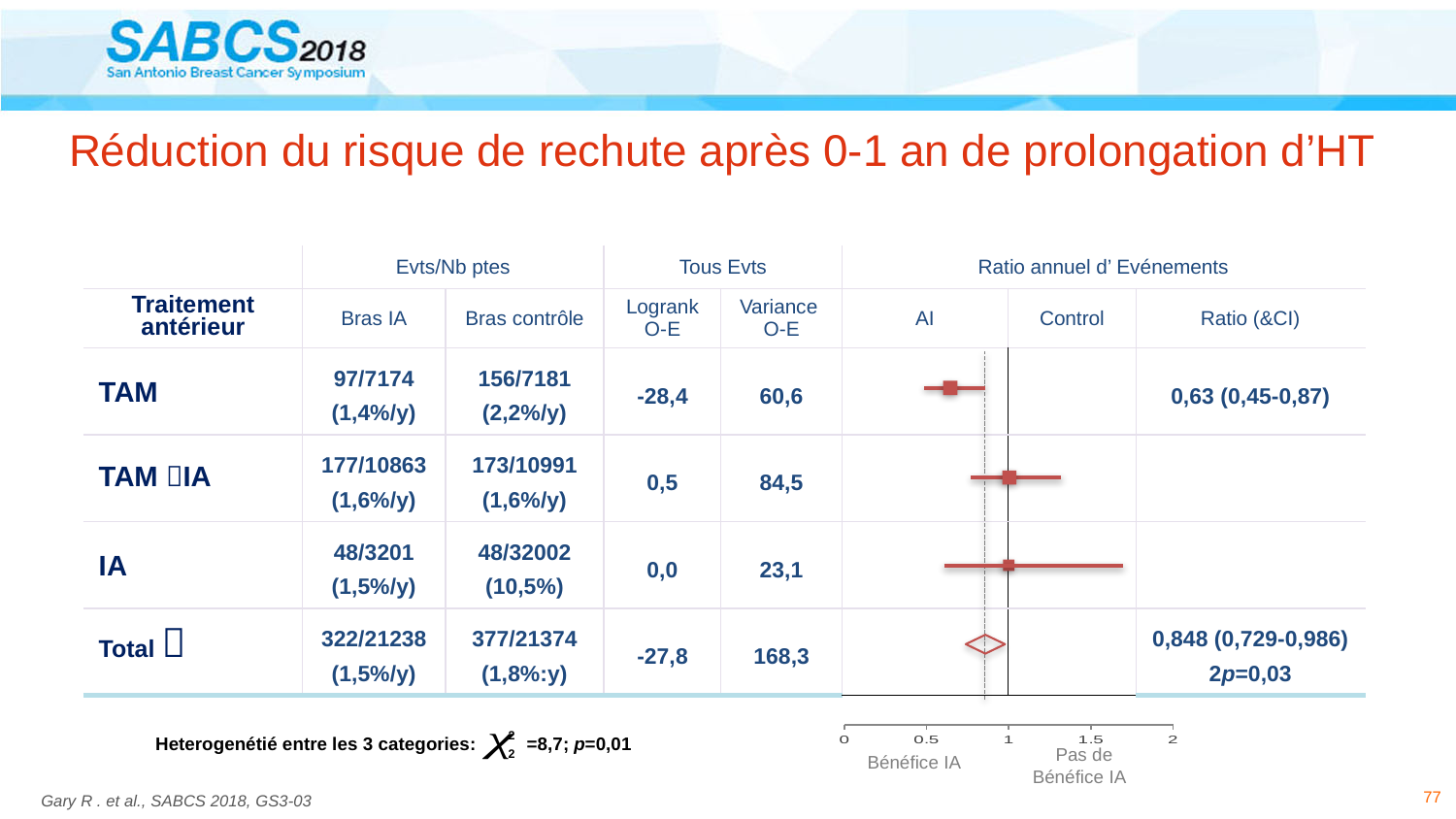
What is the ratio (with CI) shown for the TAM row in the forest plot? 0,63 (0,45-0,87) Is the ratio for IA in the forest plot greater or less than 0.5? greater What kind of chart is shown in the 'Ratio annuel d'Evénements' section of the table? forest plot What is the difference between the Total ratio and the TAM ratio in the forest plot? 0,218 What label appears under the left side of the forest plot's x axis? Bénéfice IA How many rows (treatment groups including Total) are plotted in the forest plot? 4 What is the ratio (with CI) shown for the Total row in the forest plot? 0,848 (0,729-0,986) What is the maximum value shown on the x axis of the forest plot? 2 Which ratio is larger in the forest plot, TAM or Total? Total What p-value is printed next to the Total ratio in the forest plot? 2p=0,03 Which treatment row has the lowest ratio in the forest plot? TAM Is the ratio for TAM → IA in the forest plot greater or less than 0.5? greater